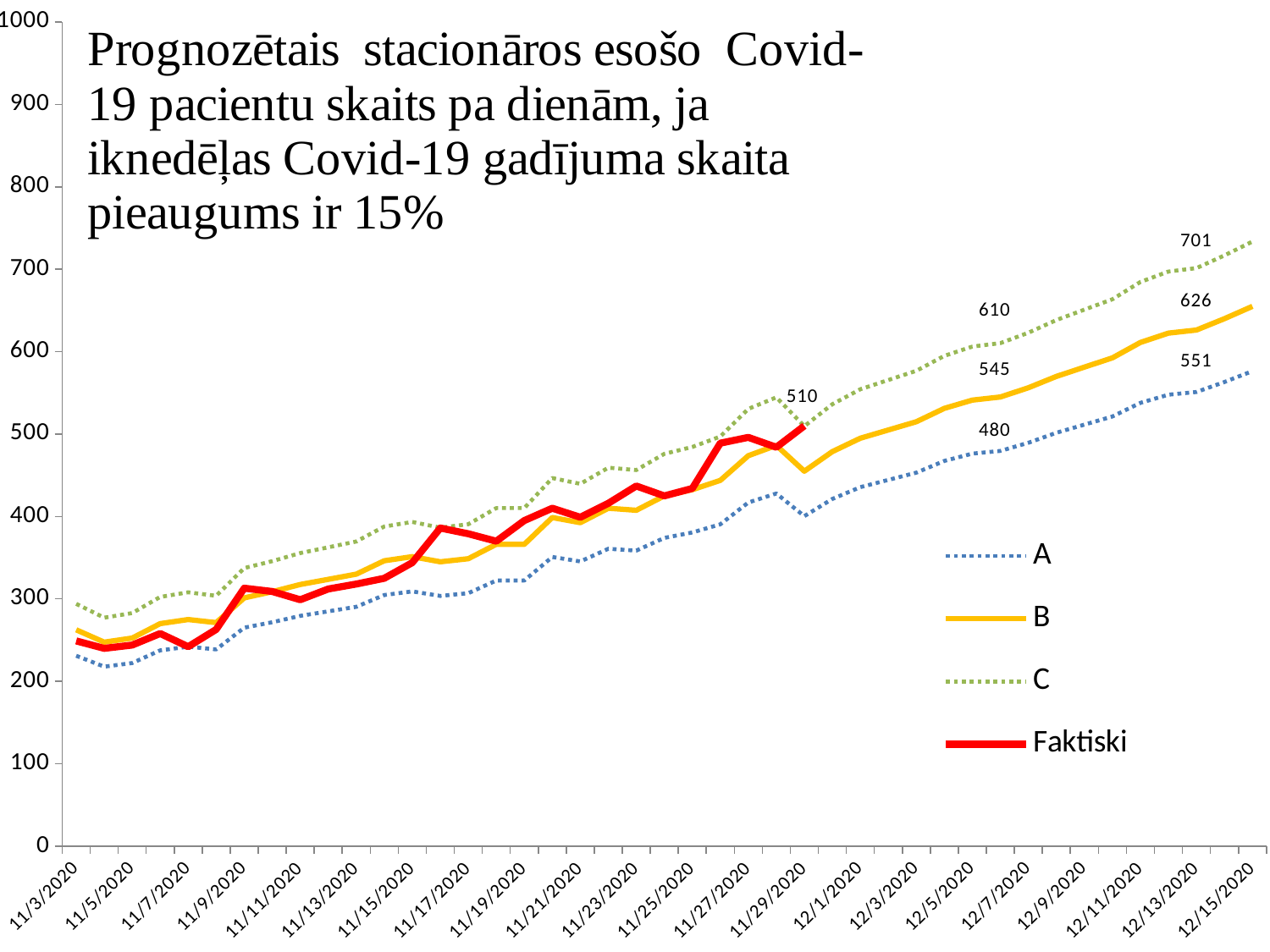
What kind of chart is shown on the slide? line chart What is the last labelled value on series B? 626 How many series does the legend list? 4 What are the series names listed in the legend? A, B, C, Faktiski What is the difference between the first labelled values of series C (610) and series B (545)? 65 Which series has the lowest value at 12/15/2020? A What is the first labelled value on series A? 480 Do the values of series B rise or fall along the x axis overall? rise What is the highest labelled value on series C? 701 Which series has the highest value at 12/15/2020? C What is the difference between the last labelled values of series C (701) and series B (626)? 75 What is the labelled value at the end of the Faktiski line (11/29/2020)? 510